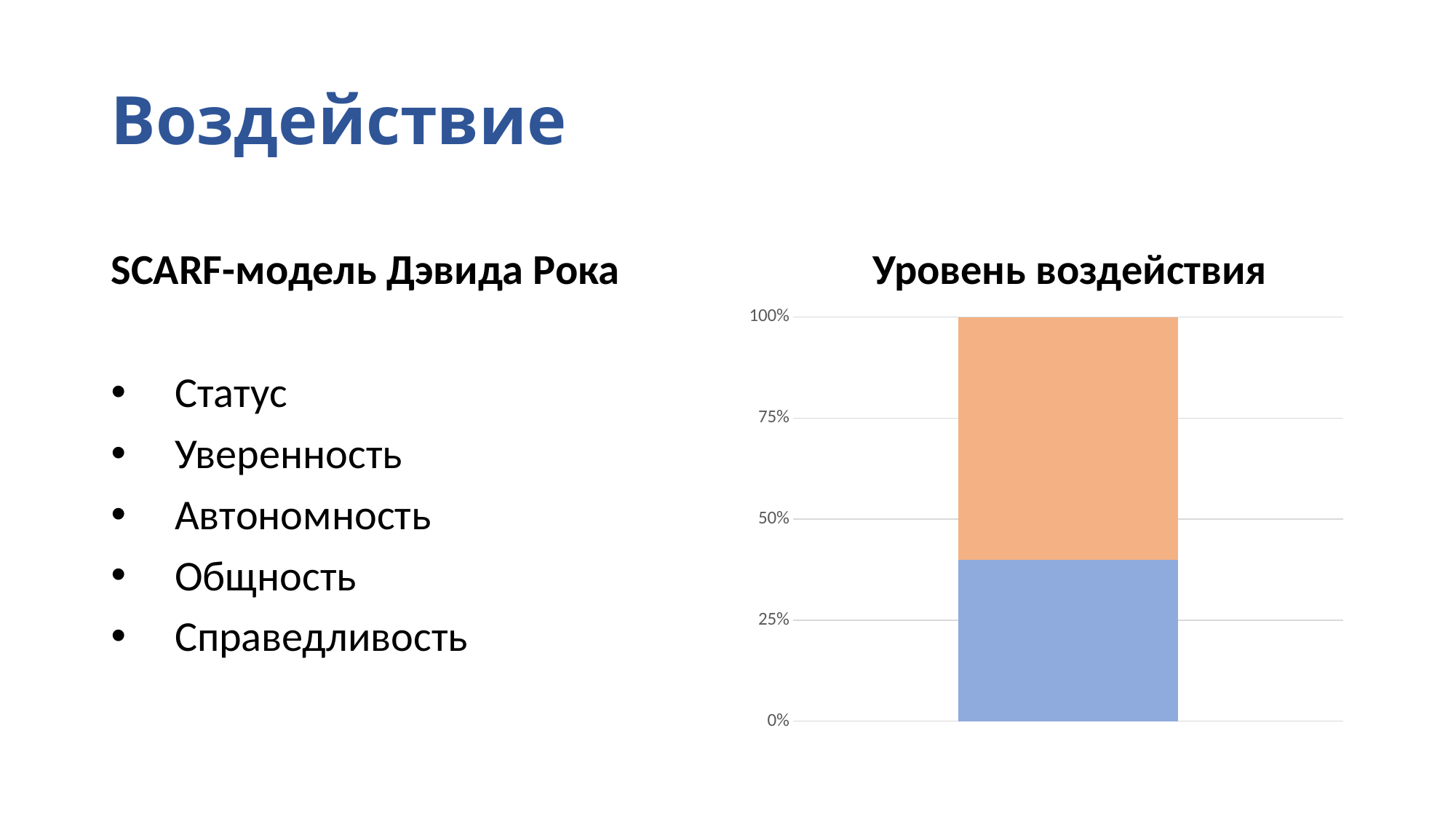
What kind of chart is shown under the title "Уровень воздействия"? bar chart In the chart "Уровень воздействия", which colour is the bottom segment of the bar? blue What is the highest value labelled on the vertical axis of the chart "Уровень воздействия"? 100% In the chart "Уровень воздействия", what value does the top of the stacked bar reach on the vertical axis? 100% In the chart "Уровень воздействия", is the blue segment greater or less than 25%? greater In the chart "Уровень воздействия", which segment is larger, the blue one or the orange one? the orange one In the chart "Уровень воздействия", is the orange segment greater or less than 50%? greater How many bars does the chart "Уровень воздействия" contain? 1 What is the title of the chart on the right side of the slide? Уровень воздействия In the chart "Уровень воздействия", is the blue segment greater or less than 50%? less How many coloured segments make up the bar in the chart "Уровень воздействия"? 2